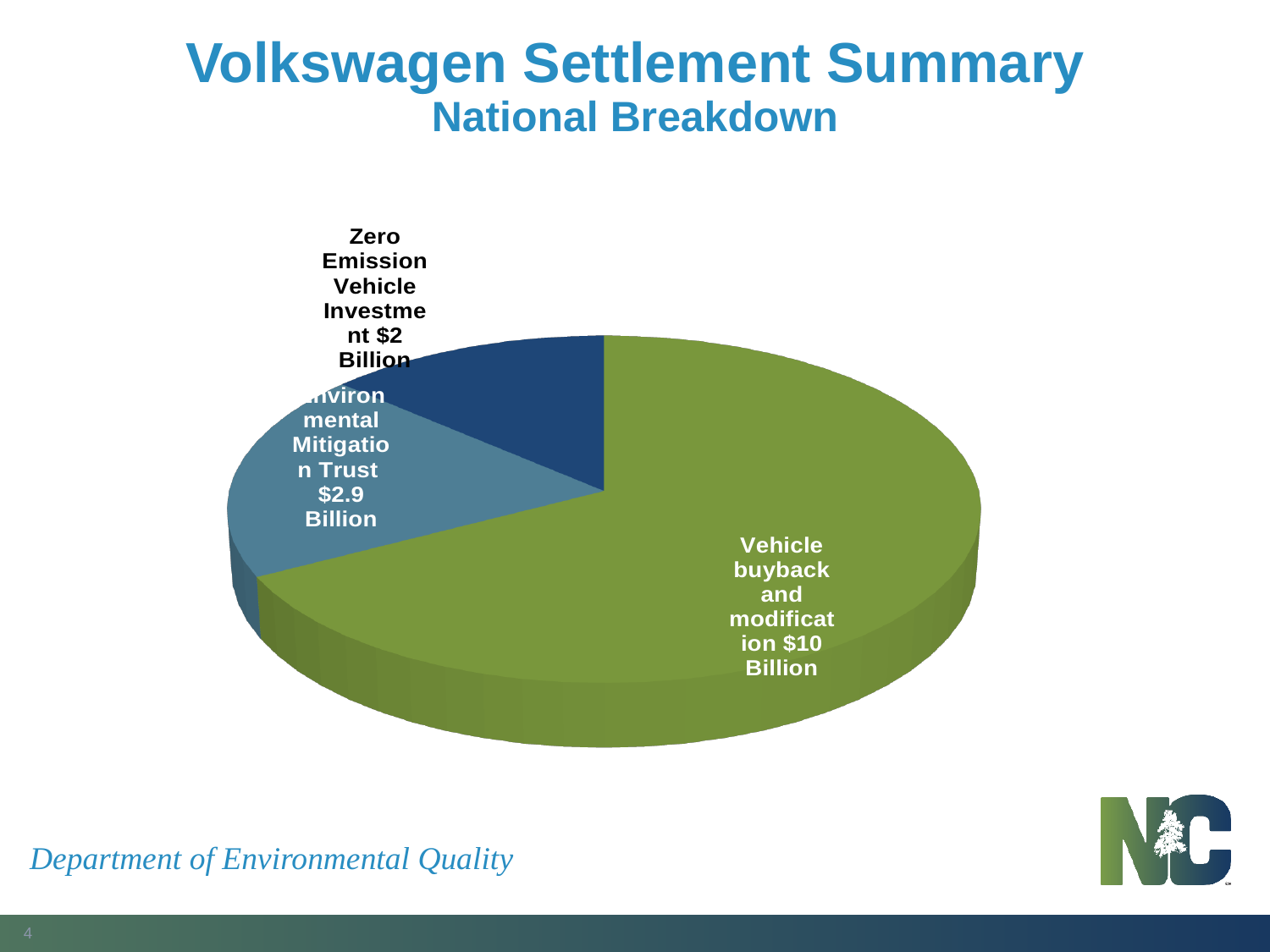
What is the total of all three slices in the pie chart? $14.9 Billion What is the value of the Environmental Mitigation Trust slice? $2.9 Billion What is the difference between the Vehicle buyback and modification value and the Environmental Mitigation Trust value? $7.1 Billion What is the value of the Zero Emission Vehicle Investment slice? $2 Billion Which category has the largest slice of the pie? Vehicle buyback and modification Which is larger, the Environmental Mitigation Trust or the Zero Emission Vehicle Investment? Environmental Mitigation Trust Which category has the smallest slice of the pie? Zero Emission Vehicle Investment What is the value of the Vehicle buyback and modification slice? $10 Billion What is the difference between the Environmental Mitigation Trust value and the Zero Emission Vehicle Investment value? $0.9 Billion What colour is the Vehicle buyback and modification slice? Green How many slices does the pie chart have? 3 What kind of chart is shown on the slide? Pie chart